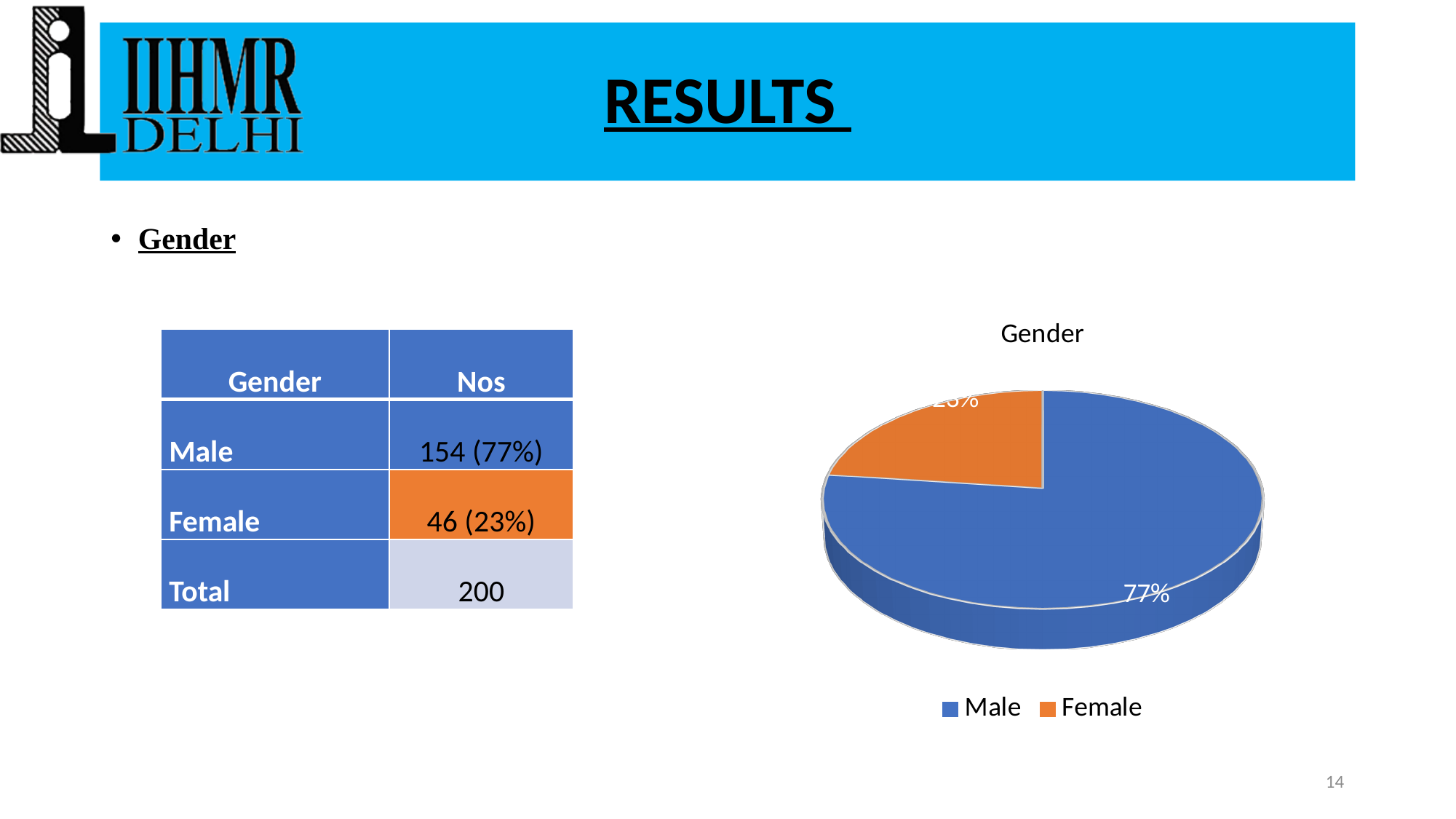
What is the difference in percentage points between the Male and Female shares in the pie chart? 54 Is the Male share in the pie chart greater or less than 50%? greater What type of chart is shown on the slide? Pie chart How many slices does the pie chart have? 2 What is the title of the pie chart? Gender What share of the pie does the Female slice represent? 23% Which colour represents Female in the pie chart? Orange How many entries does the legend of the pie chart list? 2 Which category has the smallest slice in the pie chart? Female Which category has the largest slice in the pie chart? Male Which slice is larger in the pie chart, Male or Female? Male What share of the pie does the Male slice represent? 77%